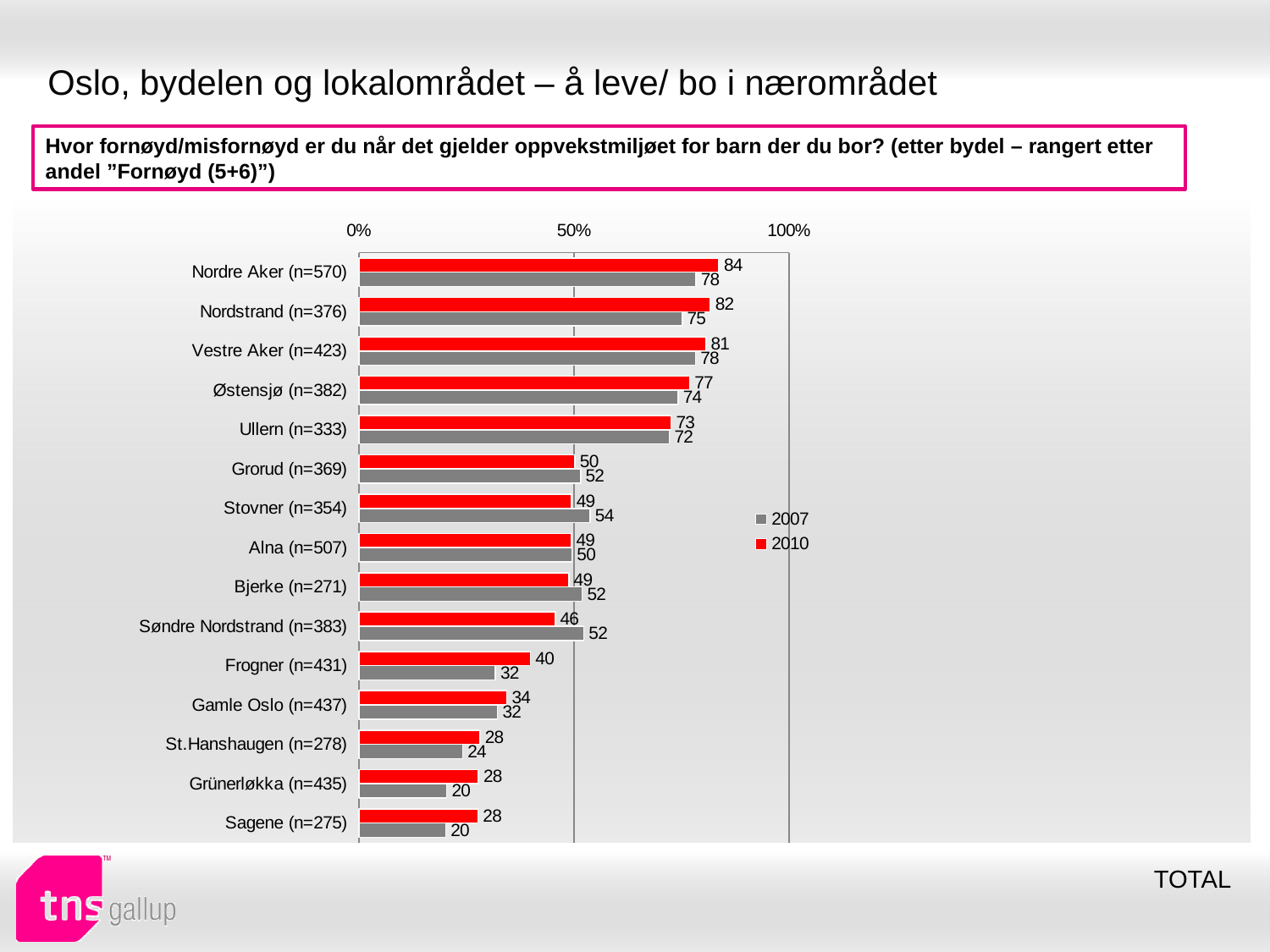
For Frogner (n=431), which year has the larger value, 2007 or 2010? 2010 Which bydel has the highest 2010 value? Nordre Aker (n=570) How many bydeler (categories) are shown in the chart? 15 What type of chart is shown on the slide? Bar chart For Stovner (n=354), which year has the larger value, 2007 or 2010? 2007 How many series does the legend list? 2 What is the 2010 value for Søndre Nordstrand (n=383)? 46 What is the difference between the 2010 values for Nordstrand (n=376) and Ullern (n=333)? 9 What is the 2007 value for Stovner (n=354)? 54 What is the difference between the 2010 and 2007 values for Grünerløkka (n=435)? 8 What is the 2007 value for Frogner (n=431)? 32 What is the 2010 value for Nordre Aker (n=570)? 84